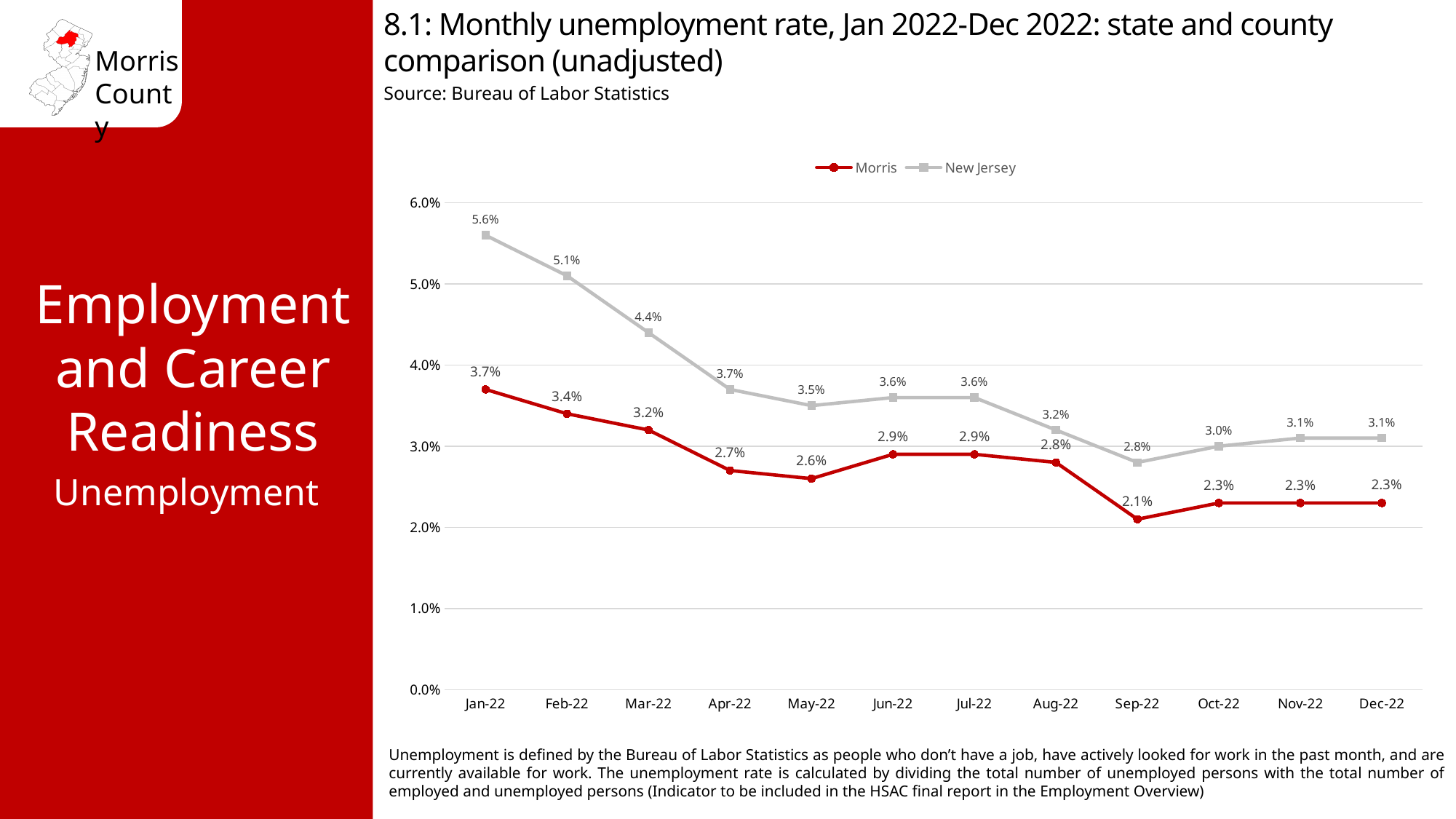
How many months are plotted on the x axis? 12 What kind of chart is shown on the slide? Line chart What was the Morris unemployment rate in Jan-22? 3.7% What is the difference between the New Jersey and Morris unemployment rates in Jan-22? 1.9% Which had the higher unemployment rate in Apr-22, Morris or New Jersey? New Jersey What was the Morris unemployment rate in Sep-22? 2.1% In which month was the New Jersey unemployment rate highest? Jan-22 In which month was the Morris unemployment rate lowest? Sep-22 How many series does the legend list? 2 What is the difference between the New Jersey and Morris unemployment rates in Dec-22? 0.8% What was the New Jersey unemployment rate in Mar-22? 4.4% Did the New Jersey unemployment rate generally rise or fall from Jan-22 to Sep-22? Fall